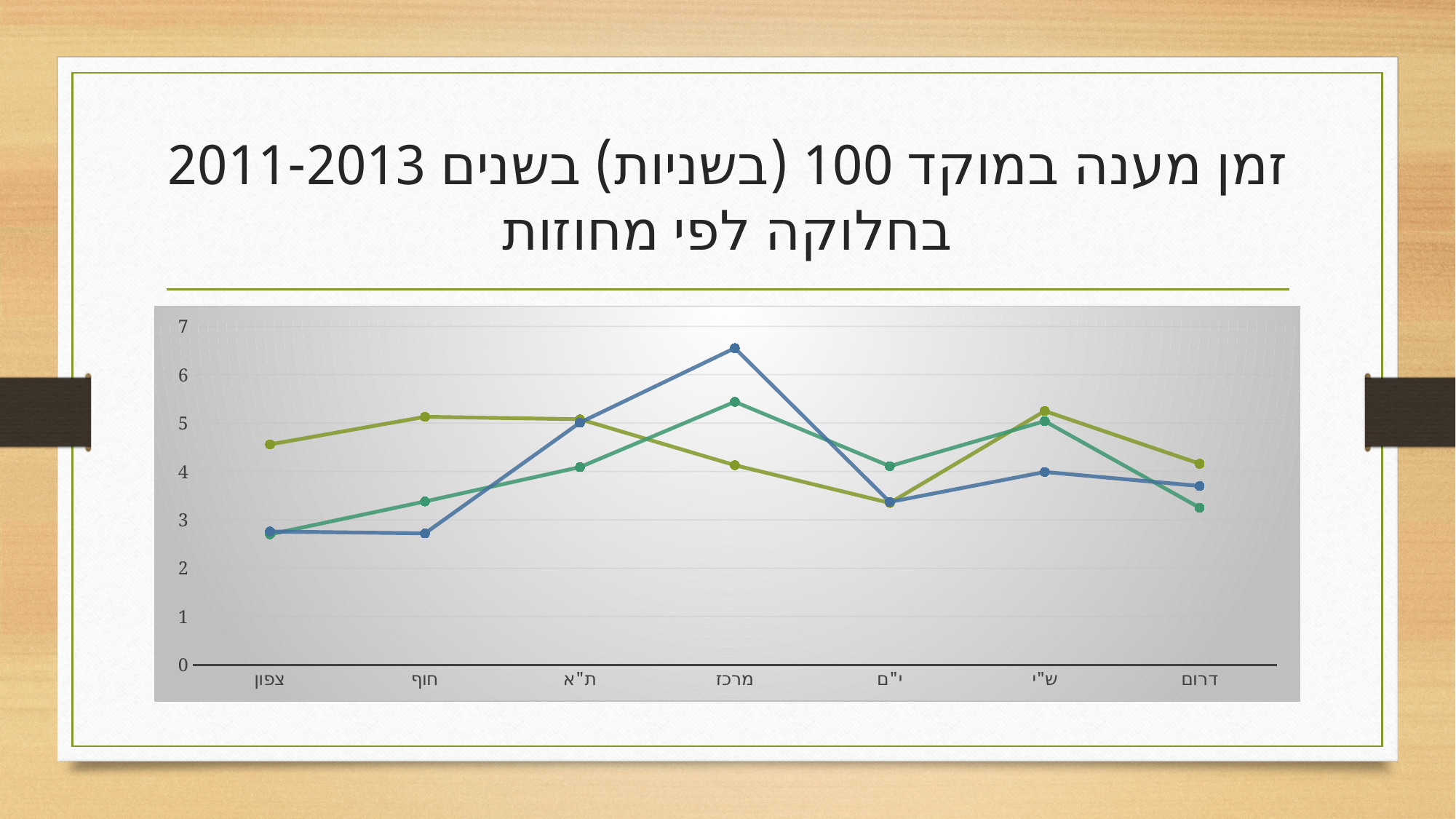
For the blue line, which category has the highest value? מרכז Is the value of the blue line at מרכז greater or less than 6? greater What kind of chart is shown on the slide? line chart How many lines are plotted on the chart? 3 Is the value of the olive line at צפון greater or less than 4? greater How many categories (districts) are shown on the x axis? 7 Is the value of the blue line at חוף greater or less than 3? less At מרכז, which line has the larger value, the blue line or the olive line? the blue line What is the title of the slide? זמן מענה במוקד 100 (בשניות) בשנים 2011-2013 בחלוקה לפי מחוזות Does the blue line rise or fall between מרכז and י"ם? fall For the olive line, which category has the lowest value? י"ם